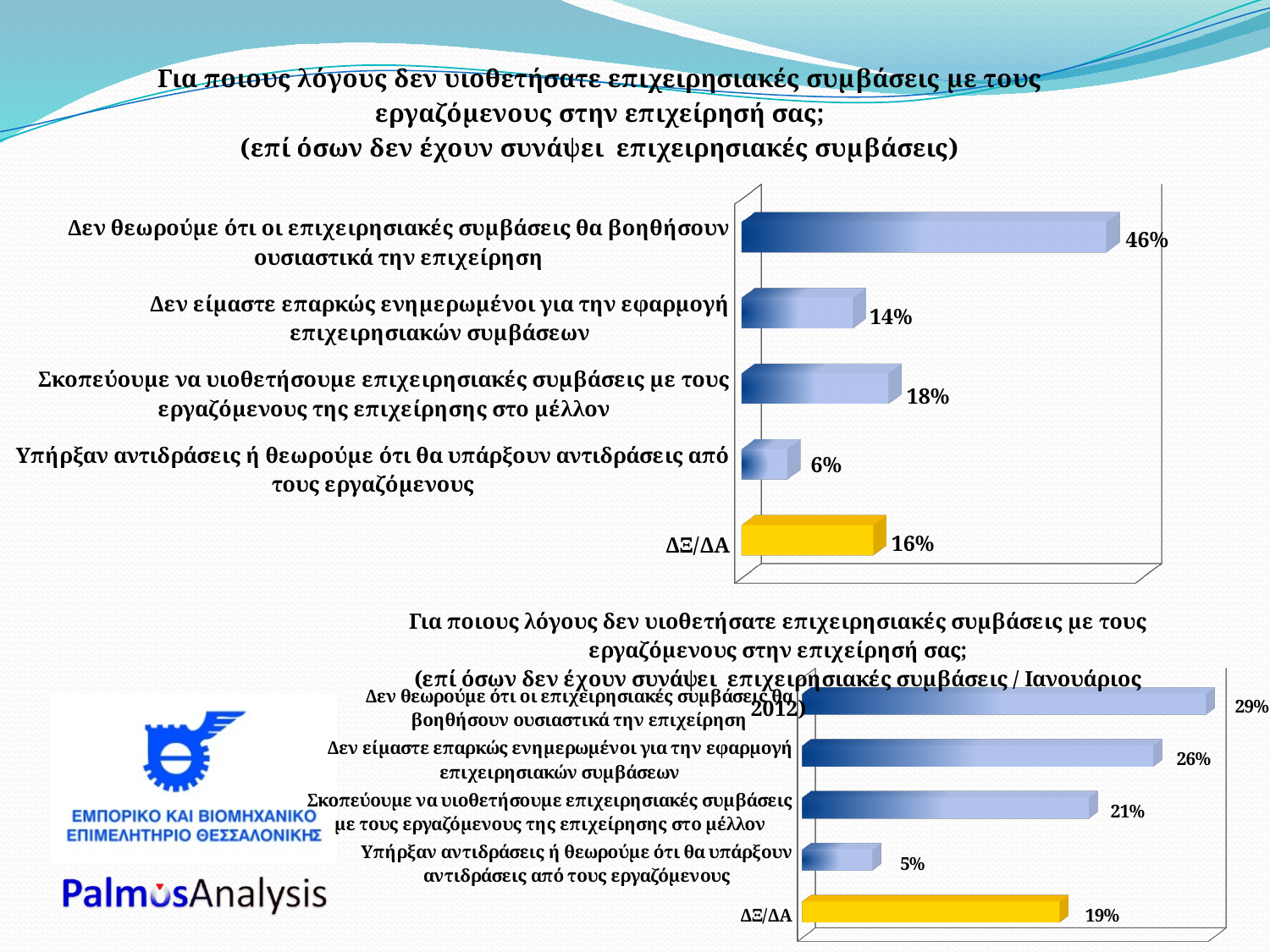
In the top chart, what is the value for 'Δεν θεωρούμε ότι οι επιχειρησιακές συμβάσεις θα βοηθήσουν ουσιαστικά την επιχείρηση'? 46% In the top chart, what is the difference between 'Σκοπεύουμε να υιοθετήσουμε επιχειρησιακές συμβάσεις με τους εργαζόμενους της επιχείρησης στο μέλλον' and 'Δεν είμαστε επαρκώς ενημερωμένοι για την εφαρμογή επιχειρησιακών συμβάσεων'? 4% In the top chart, which is larger: 'ΔΞ/ΔΑ' or 'Δεν είμαστε επαρκώς ενημερωμένοι για την εφαρμογή επιχειρησιακών συμβάσεων'? ΔΞ/ΔΑ In the bottom chart (Ιανουάριος 2012), what is the value for 'Δεν είμαστε επαρκώς ενημερωμένοι για την εφαρμογή επιχειρησιακών συμβάσεων'? 26% In the bottom chart (Ιανουάριος 2012), what is the value for 'Υπήρξαν αντιδράσεις ή θεωρούμε ότι θα υπάρξουν αντιδράσεις από τους εργαζόμενους'? 5% In the top chart, what is the value for 'ΔΞ/ΔΑ'? 16% In the top chart, which category has the lowest value? Υπήρξαν αντιδράσεις ή θεωρούμε ότι θα υπάρξουν αντιδράσεις από τους εργαζόμενους How many categories does the bottom chart (Ιανουάριος 2012) show? 5 In the bottom chart (Ιανουάριος 2012), which category has the lowest value? Υπήρξαν αντιδράσεις ή θεωρούμε ότι θα υπάρξουν αντιδράσεις από τους εργαζόμενους What type of chart is the top chart? Bar chart In the bottom chart (Ιανουάριος 2012), what is the difference between the highest value and 'ΔΞ/ΔΑ'? 10% In the top chart, which category has the highest value? Δεν θεωρούμε ότι οι επιχειρησιακές συμβάσεις θα βοηθήσουν ουσιαστικά την επιχείρηση